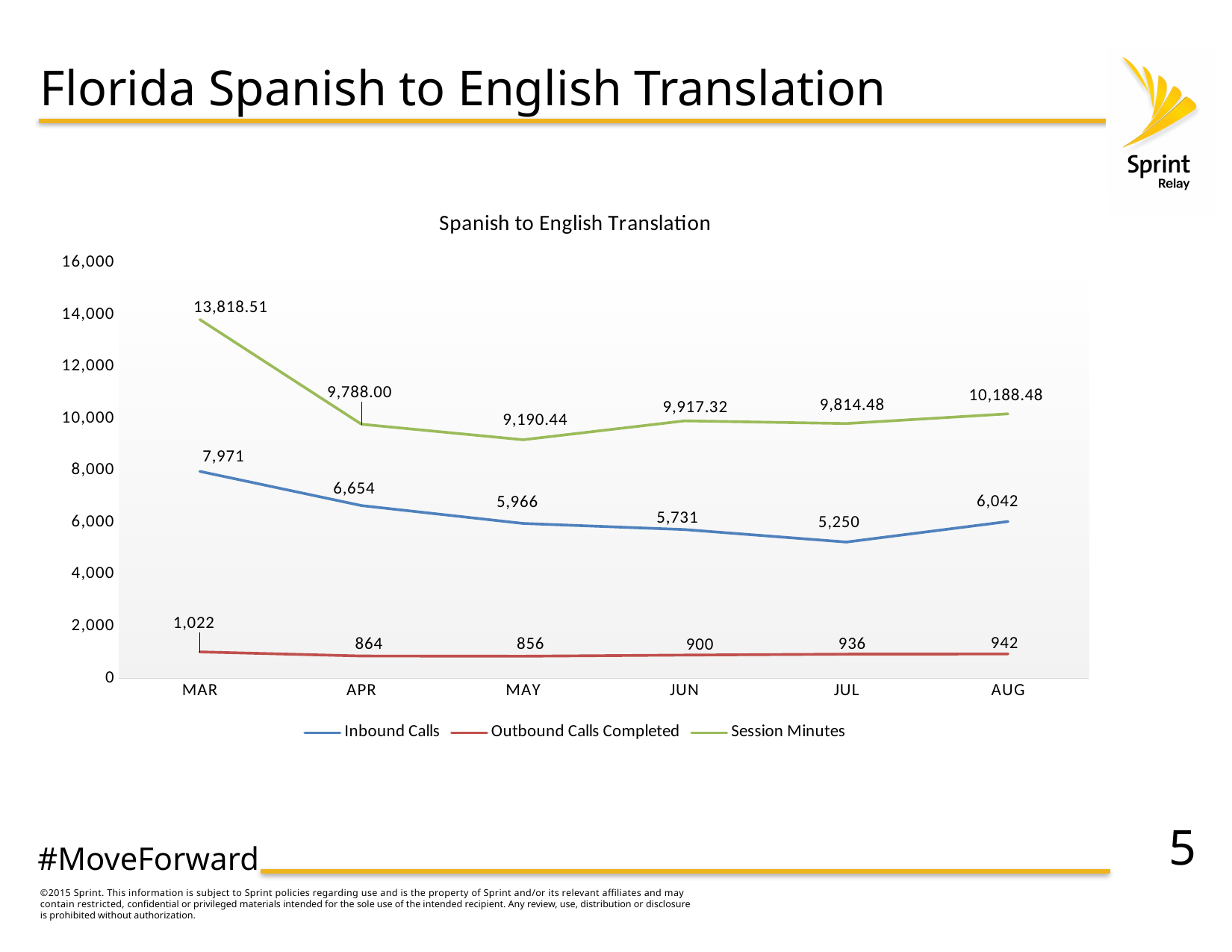
What kind of chart is shown on the slide? Line chart In which month are Session Minutes highest? MAR How many series does the legend list? 3 What is the value of Inbound Calls in MAR? 7,971 What is the difference between Inbound Calls in MAR and in APR? 1,317 How many months are shown on the x axis? 6 What is the value of Outbound Calls Completed in JUN? 900 Do Inbound Calls rise or fall from MAR to JUL? Fall Which is larger: Session Minutes in JUN or Session Minutes in JUL? JUN In which month are Inbound Calls lowest? JUL In which month are Outbound Calls Completed lowest? MAY What is the value of Session Minutes in AUG? 10,188.48